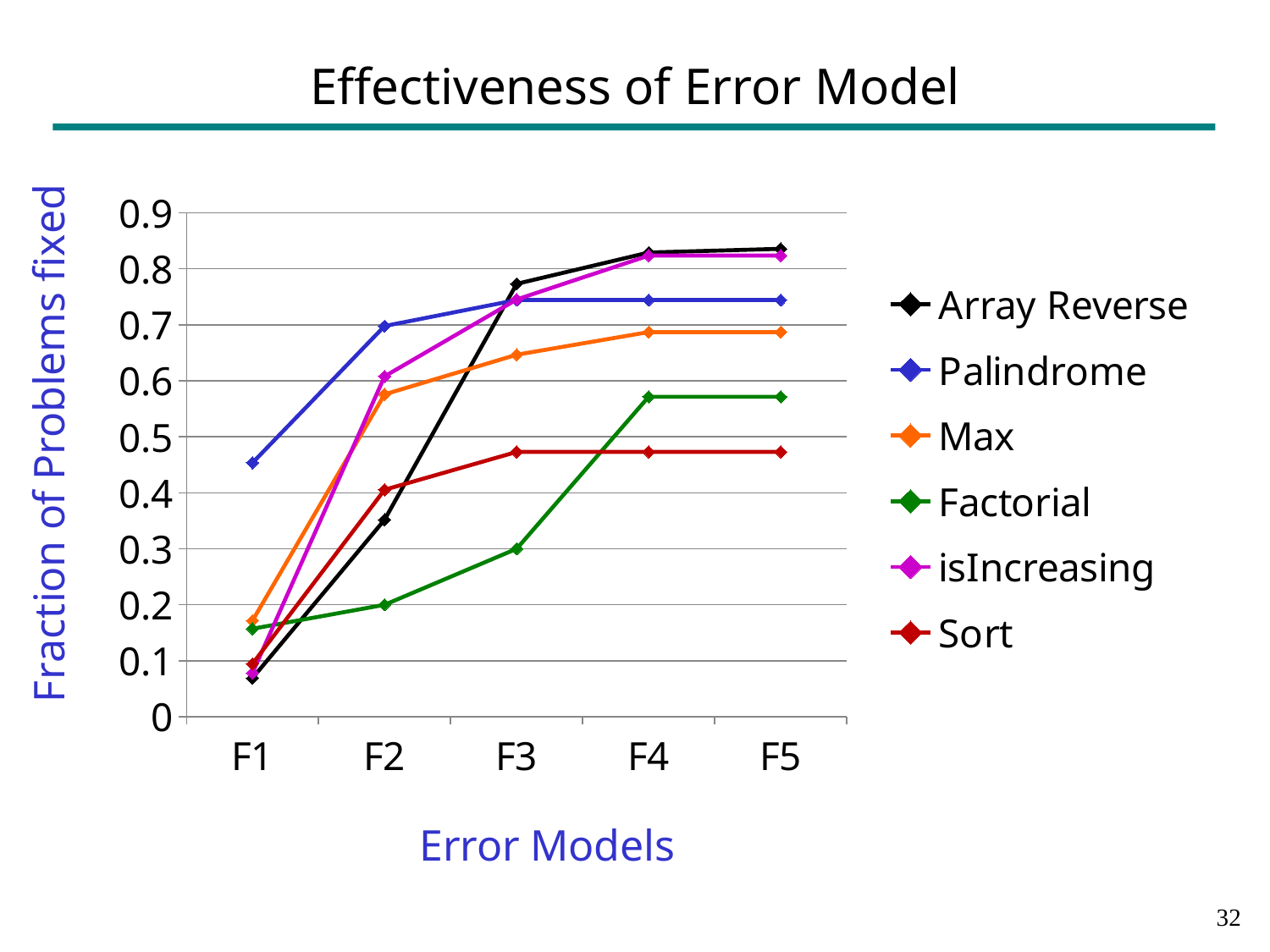
Is the value for Array Reverse at F5 greater or less than 0.8? greater How many series does the legend list? 6 What kind of chart is shown on the slide? line chart Which series has the lowest value at F5? Sort Is the value for Palindrome at F1 greater or less than 0.4? greater Which series has the highest value at F2? Palindrome Which series has the lowest value at F3? Factorial How many error models are shown on the x axis? 5 At F5, which is larger: the value for Max or the value for Factorial? Max Does the Array Reverse series rise or fall from F1 to F5? rise Which series has the highest value at F1? Palindrome Is the value for Factorial at F3 greater or less than 0.4? less